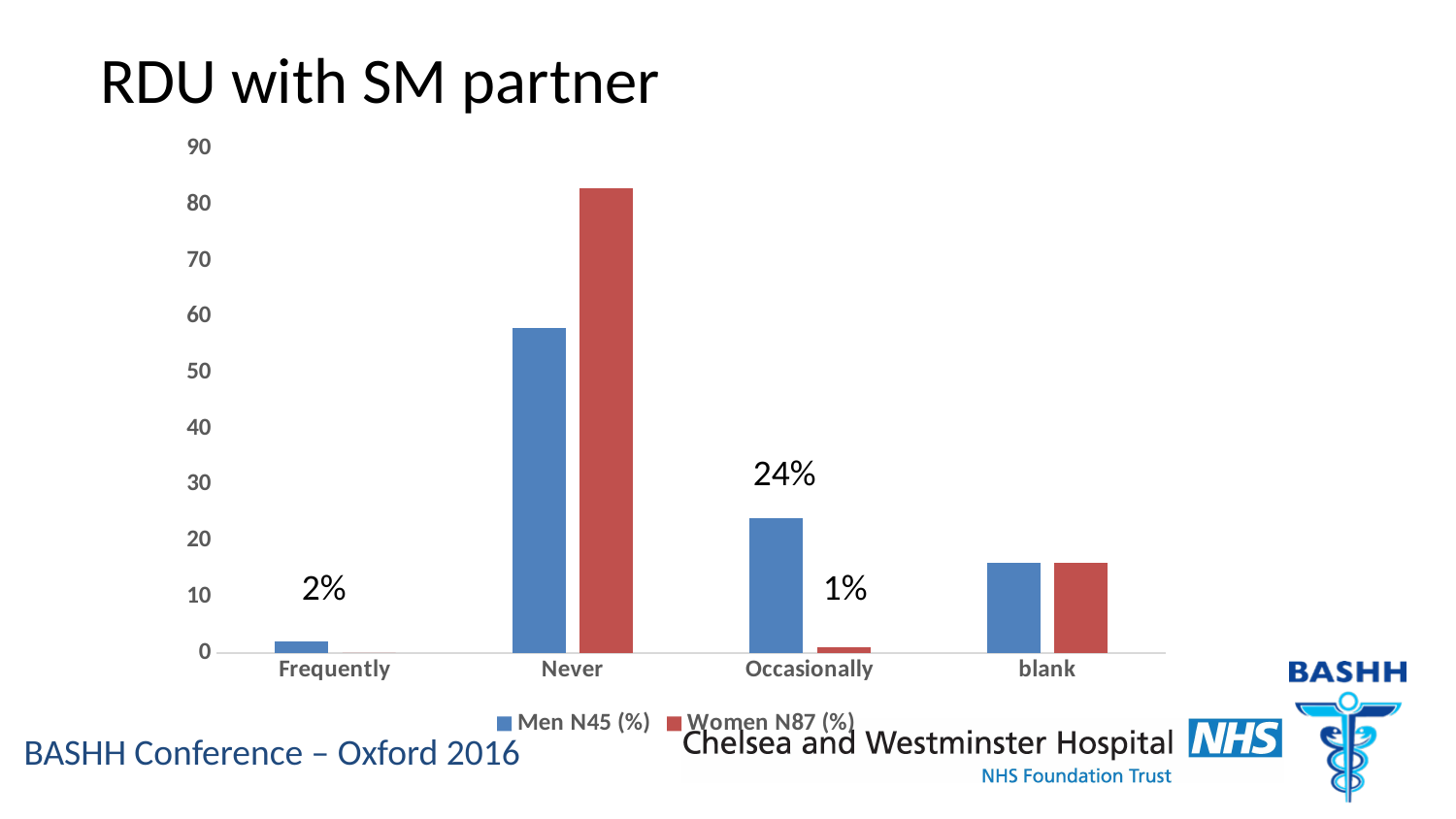
What is the value for Men N45 (%) in the Frequently category? 2% Is the value for Men N45 (%) in the Never category greater or less than 50? greater How many categories are shown on the x axis? 4 How many series does the legend list? 2 What is the value for Women N87 (%) in the Occasionally category? 1% What is the value for Men N45 (%) in the Occasionally category? 24% In the Never category, which series has the larger value, Men N45 (%) or Women N87 (%)? Women N87 (%) Which category has the lowest value for Men N45 (%)? Frequently Which category has the highest value for Women N87 (%)? Never What is the difference between the Men N45 (%) and Women N87 (%) values in the Occasionally category? 23% What type of chart is shown on the slide? Bar chart Is the value for Women N87 (%) in the Never category greater or less than 70? greater